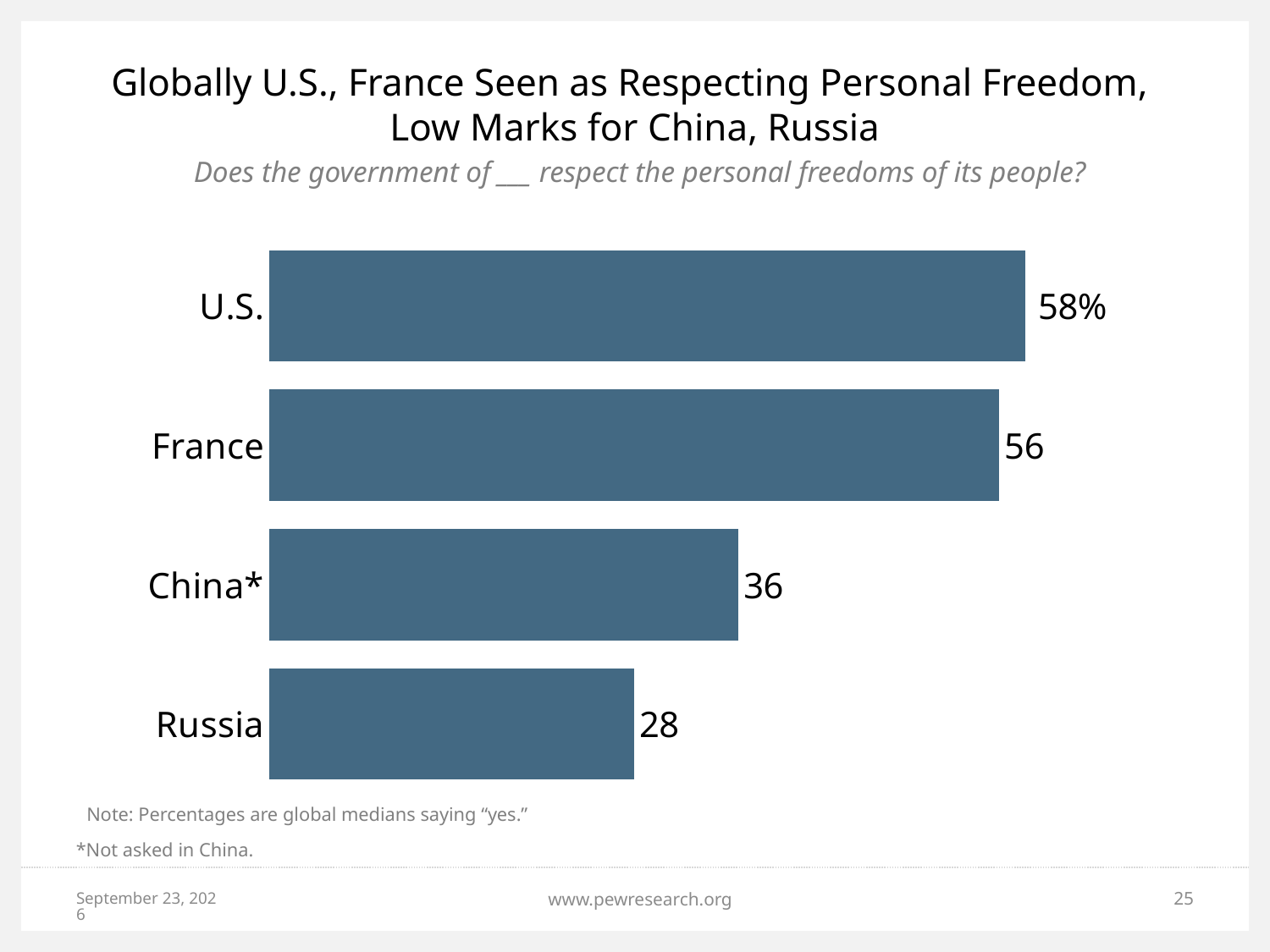
What value is shown for Russia? 28 What value is shown for France? 56 Which country has the highest value? U.S. Which country has the lowest value? Russia What is the difference between the values for the U.S. and Russia? 30 What value is shown for China*? 36 Which has a larger value, China* or Russia? China* What kind of chart is this? Bar chart What percentage is shown for the U.S.? 58% What question does the chart's subtitle say respondents were asked? Does the government of ___ respect the personal freedoms of its people? How many countries are shown in the chart? 4 What is the difference between the values for France and China*? 20